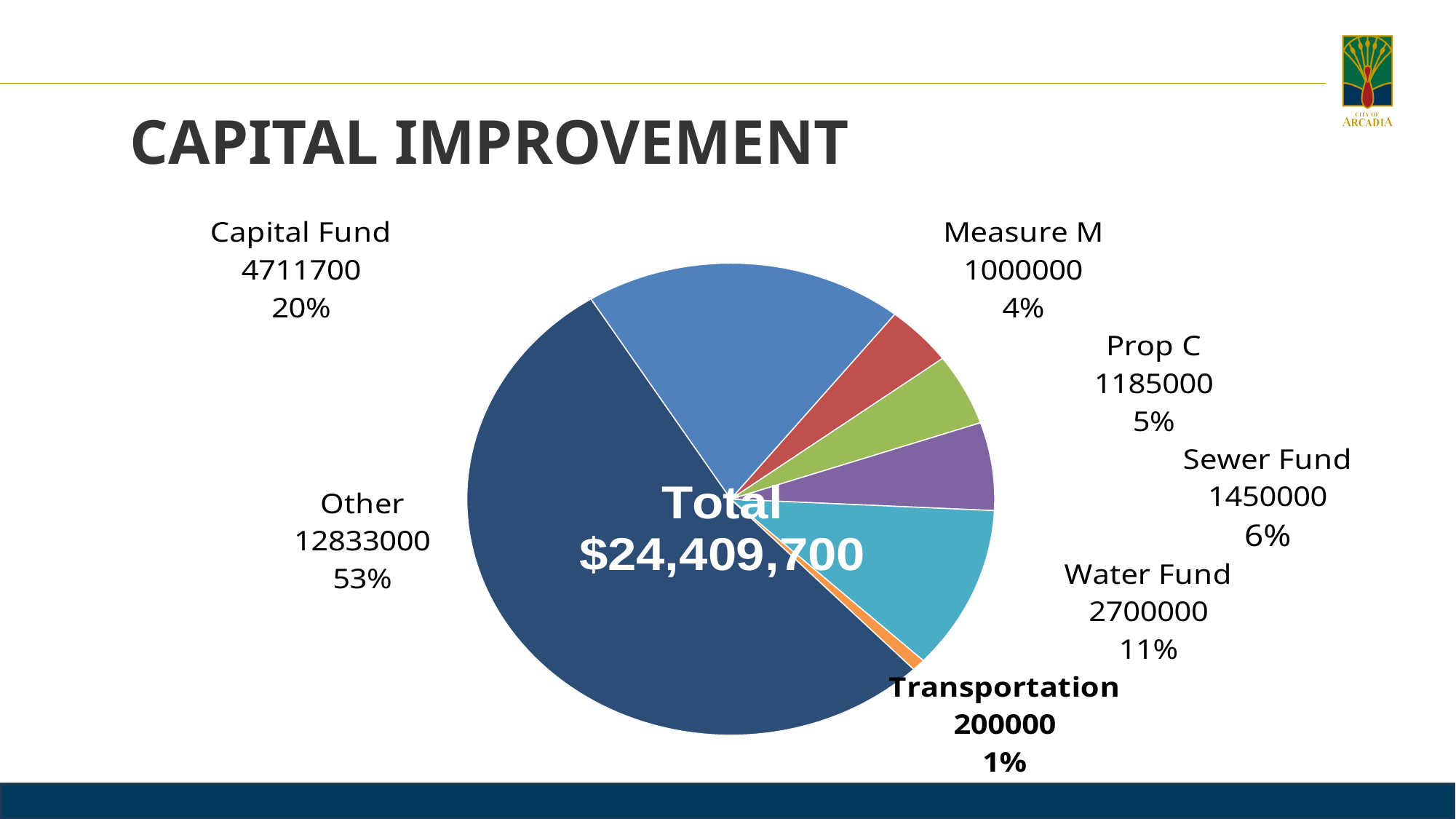
How many slices does the pie chart have? 7 Which is larger, the Water Fund value or the Sewer Fund value? Water Fund Which category has the smallest slice of the pie? Transportation What is the value for the Capital Fund slice? 4711700 What is the difference between the Prop C value and the Measure M value? 185000 What kind of chart is shown on the slide? Pie chart What is the title of the slide containing the pie chart? CAPITAL IMPROVEMENT What is the value for the Water Fund slice? 2700000 What total is printed in the centre of the pie chart? $24,409,700 What percentage share does the Sewer Fund slice have? 6% Which category has the largest slice of the pie? Other What percentage share does the Other slice have? 53%